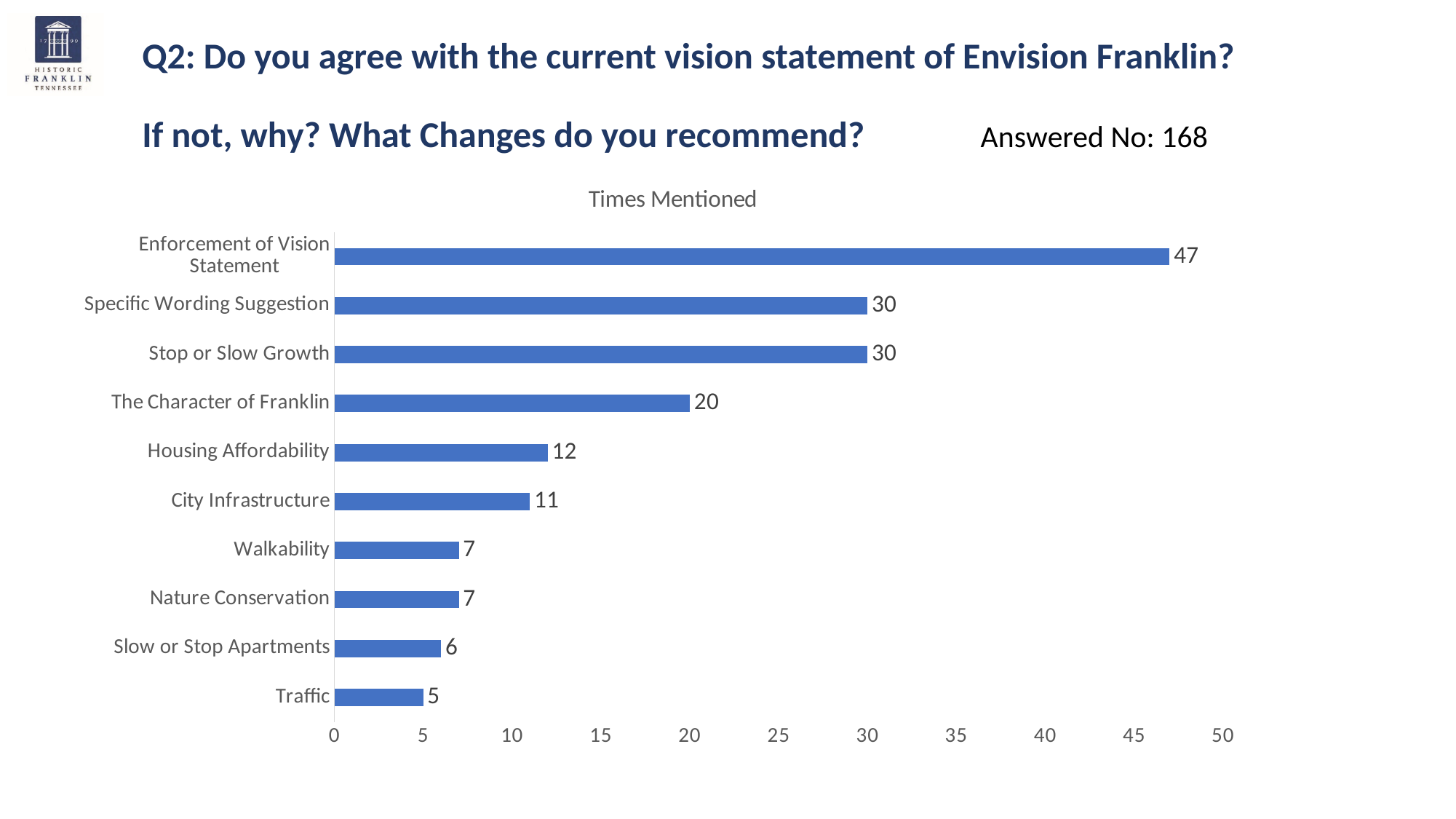
What is the difference between Enforcement of Vision Statement and Stop or Slow Growth? 17 What is the value for Housing Affordability? 12 What is the title of the chart? Times Mentioned How many categories are shown in the chart? 10 Which category has the lowest number of times mentioned? Traffic Which is larger, Housing Affordability or Slow or Stop Apartments? Housing Affordability What kind of chart is shown on the slide? Bar chart How many times was City Infrastructure mentioned? 11 Is the value for Specific Wording Suggestion greater or less than 25? greater What is the difference between The Character of Franklin and Traffic? 15 Which category has the highest number of times mentioned? Enforcement of Vision Statement How many times was Enforcement of Vision Statement mentioned? 47